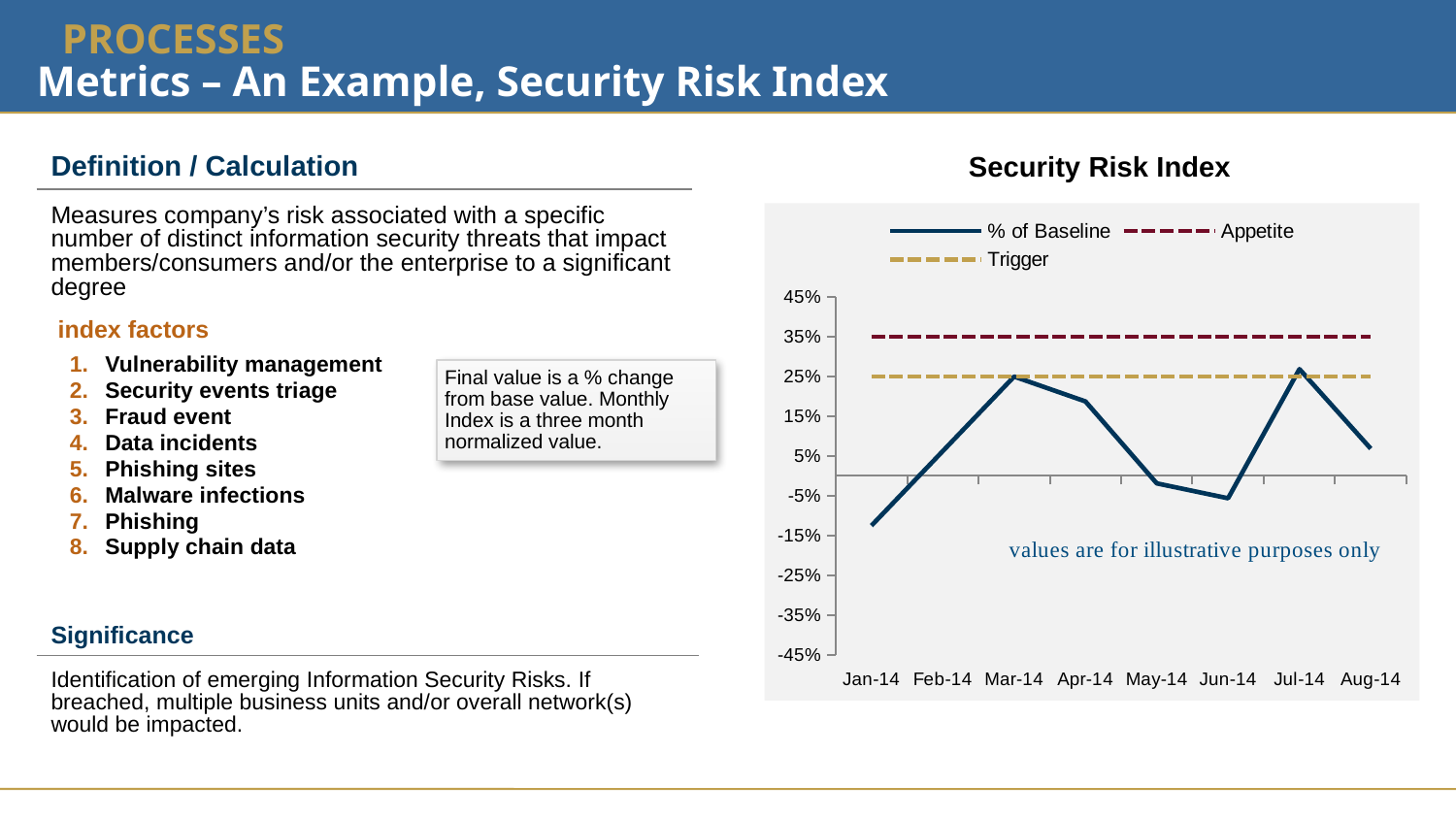
Is the % of Baseline value for Apr-14 greater or less than 15%? greater What is the value of the Appetite line in the Security Risk Index chart? 35% Is the % of Baseline value for Jan-14 greater or less than -5%? less What is the difference between the Appetite line and the Trigger line in the Security Risk Index chart? 10% How many series does the legend of the Security Risk Index chart list? 3 In which month is the % of Baseline lowest in the Security Risk Index chart? Jan-14 What is the value of the Trigger line in the Security Risk Index chart? 25% What kind of chart is the Security Risk Index chart? line chart Which is higher in the Security Risk Index chart, the Appetite line or the Trigger line? Appetite Does the % of Baseline line rise or fall from Mar-14 to Jun-14? fall Which month has the larger % of Baseline value, Feb-14 or Apr-14? Apr-14 How many months are plotted along the x axis of the Security Risk Index chart? 8